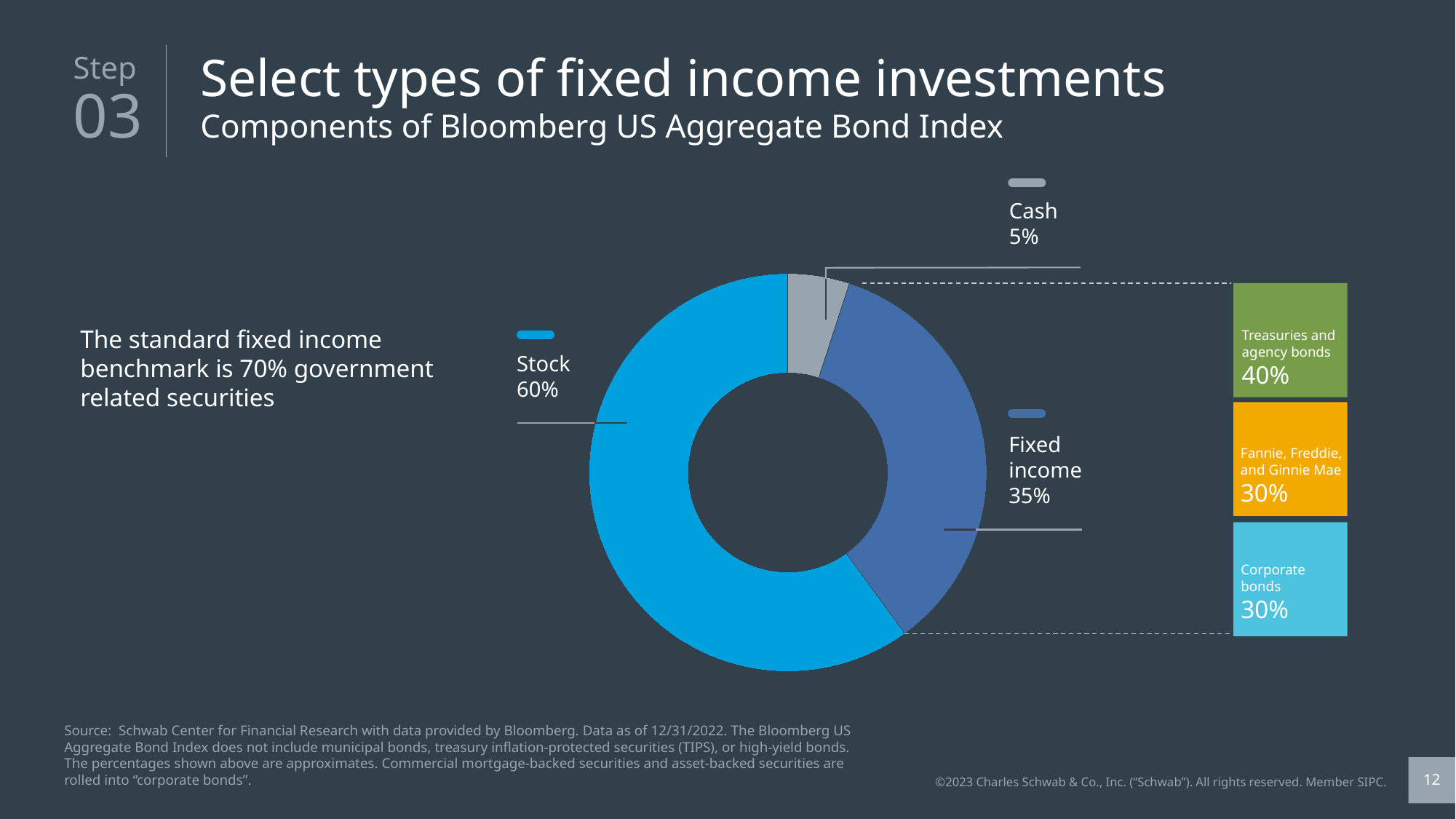
In the fixed income breakdown boxes, what share is Treasuries and agency bonds? 40% What colour is the Stock slice of the donut chart? Light blue What percentage of the donut chart is Fixed income? 35% Which slice of the donut chart is the smallest? Cash In the fixed income breakdown boxes, what share is Corporate bonds? 30% Which is larger in the donut chart, Fixed income or Cash? Fixed income Which slice of the donut chart is the largest? Stock What percentage of the donut chart is Stock? 60% What kind of chart is shown on the slide? Donut (pie) chart How many slices does the donut chart have? 3 What percentage of the donut chart is Cash? 5% What is the difference in percentage points between the Stock slice and the Fixed income slice? 25 percentage points